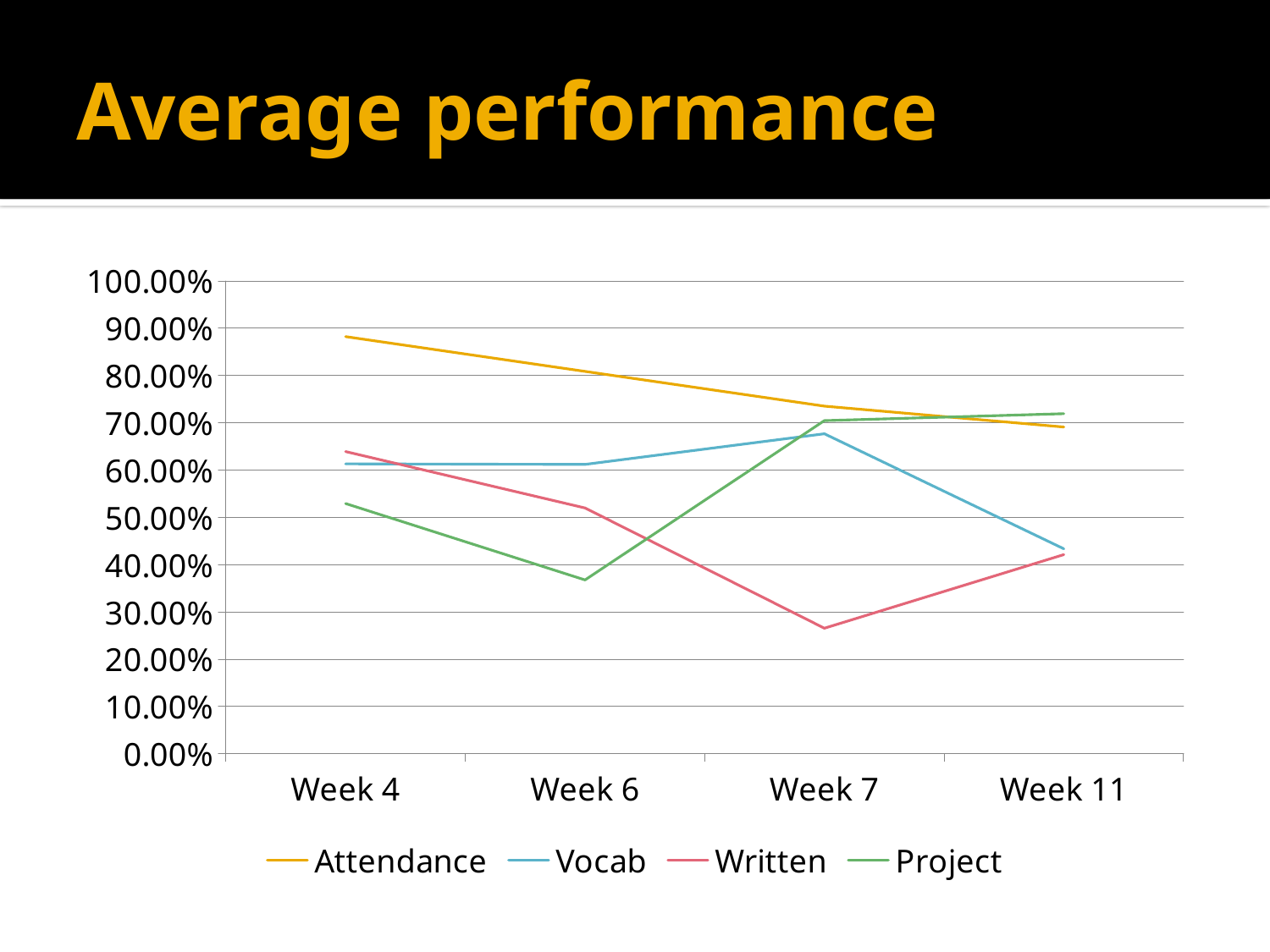
What is the title of the slide containing the chart? Average performance Which series has the lowest value at Week 6? Project Does the Attendance line rise or fall from Week 4 to Week 11? Fall Is the Written value at Week 7 greater or less than 30.00%? less How many weeks are plotted along the x axis? 4 Is the Attendance value at Week 4 greater or less than 80.00%? greater Which series has the highest value at Week 4? Attendance At Week 11, which is larger: the Project value or the Vocab value? Project Is the Project value at Week 6 greater or less than 40.00%? less At which week is the Written series at its lowest? Week 7 How many series does the legend list? 4 What kind of chart is shown on the slide? Line chart